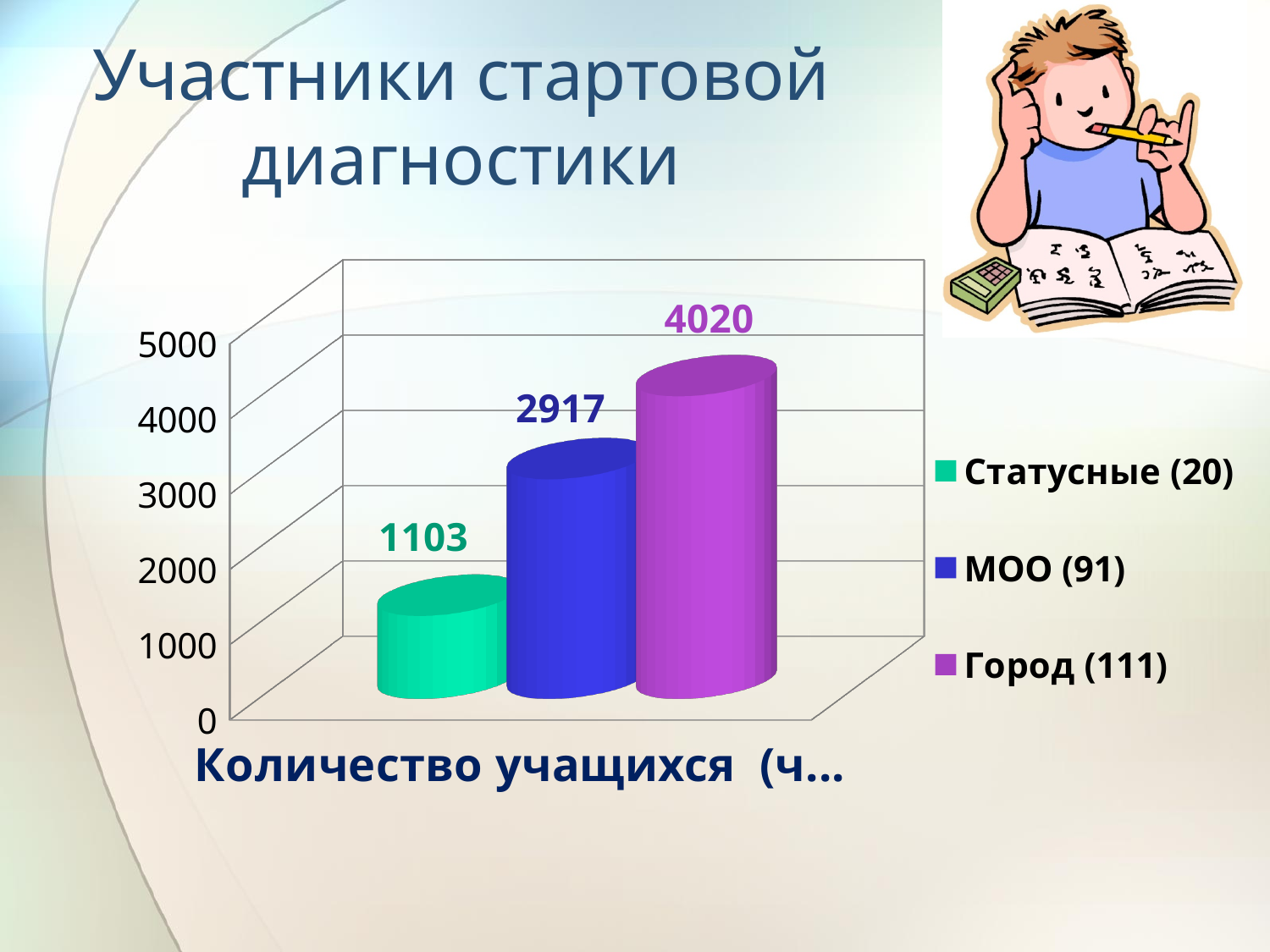
Is the value for Город (111) greater or less than 3000? greater What is the value for МОО (91)? 2917 Which series has the lowest value? Статусные (20) What is the value for Статусные (20)? 1103 What kind of chart is shown on the slide? bar chart What is the difference between the values for МОО (91) and Статусные (20)? 1814 How many series does the legend list? 3 What is the value for Город (111)? 4020 What colour is the bar for Город (111)? purple Which series has the highest value? Город (111) Which is larger, the value for МОО (91) or the value for Статусные (20)? МОО (91) What is the difference between the values for Город (111) and МОО (91)? 1103